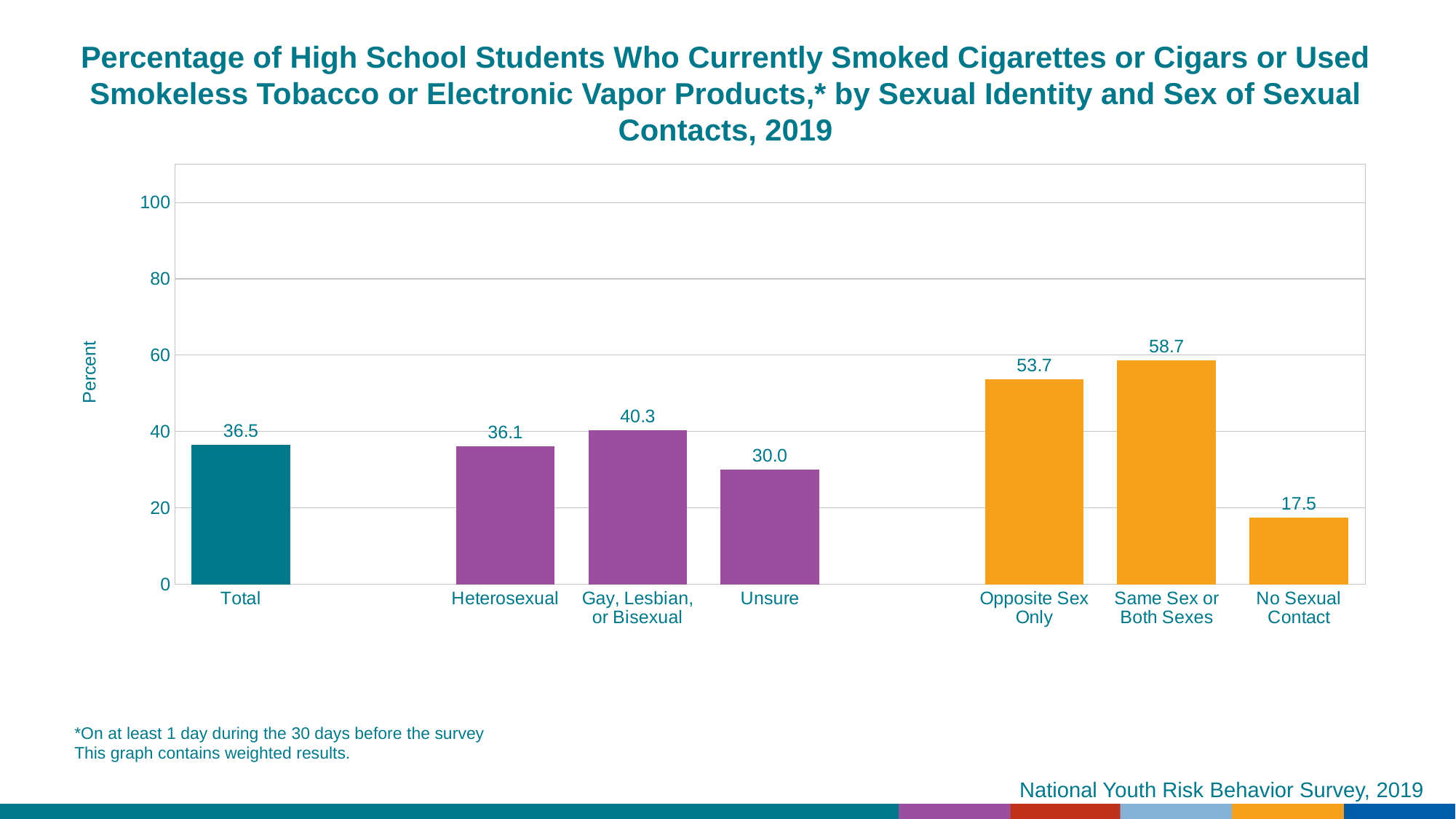
What is the difference between the values for Same Sex or Both Sexes and Opposite Sex Only? 5.0 Which is larger, the value for Gay, Lesbian, or Bisexual or the value for Unsure? Gay, Lesbian, or Bisexual Is the value for Opposite Sex Only greater or less than 40? greater What is the value for students with No Sexual Contact? 17.5 What is the value for Heterosexual students? 36.1 What is the value for Total? 36.5 Which category has the lowest value? No Sexual Contact What kind of chart is shown on the slide? Bar chart Which category has the highest value? Same Sex or Both Sexes What is the value for Gay, Lesbian, or Bisexual students? 40.3 What is the label of the y axis? Percent How many bars are shown in the chart? 7